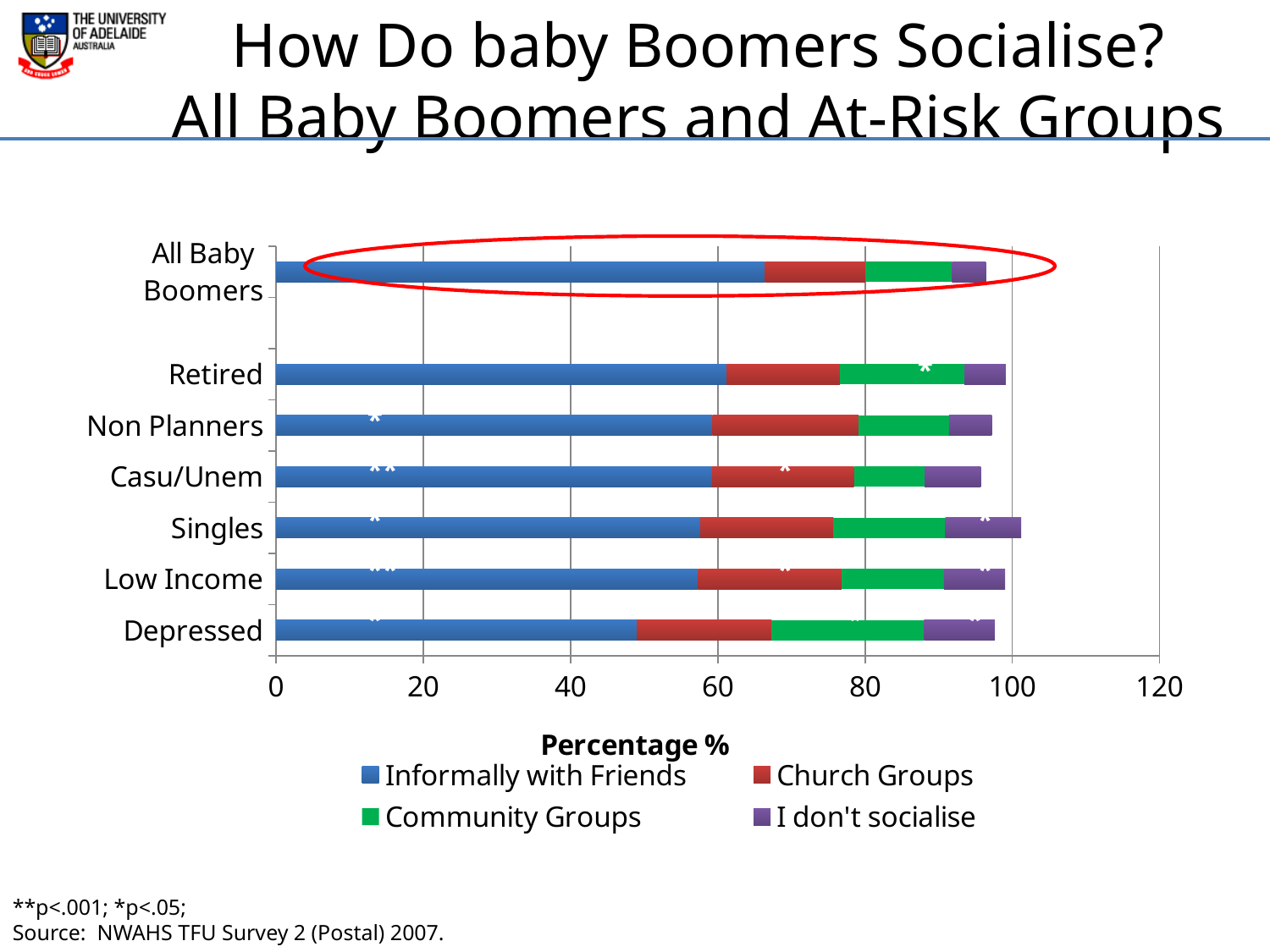
Is the total length of the Depressed stacked bar greater or less than 100? less What kind of chart is shown on the slide? bar chart Is the total length of the Casu/Unem stacked bar greater or less than 100? less Which has the larger 'Informally with Friends' segment, Singles or Depressed? Singles What is the title of the x axis? Percentage % Which category has the smallest 'Informally with Friends' segment? Depressed How many series does the legend list? 4 How many categories (groups) are plotted on the chart? 7 Is the 'Informally with Friends' value for Depressed greater or less than 60? less Which category's bar is circled in red on the chart? All Baby Boomers